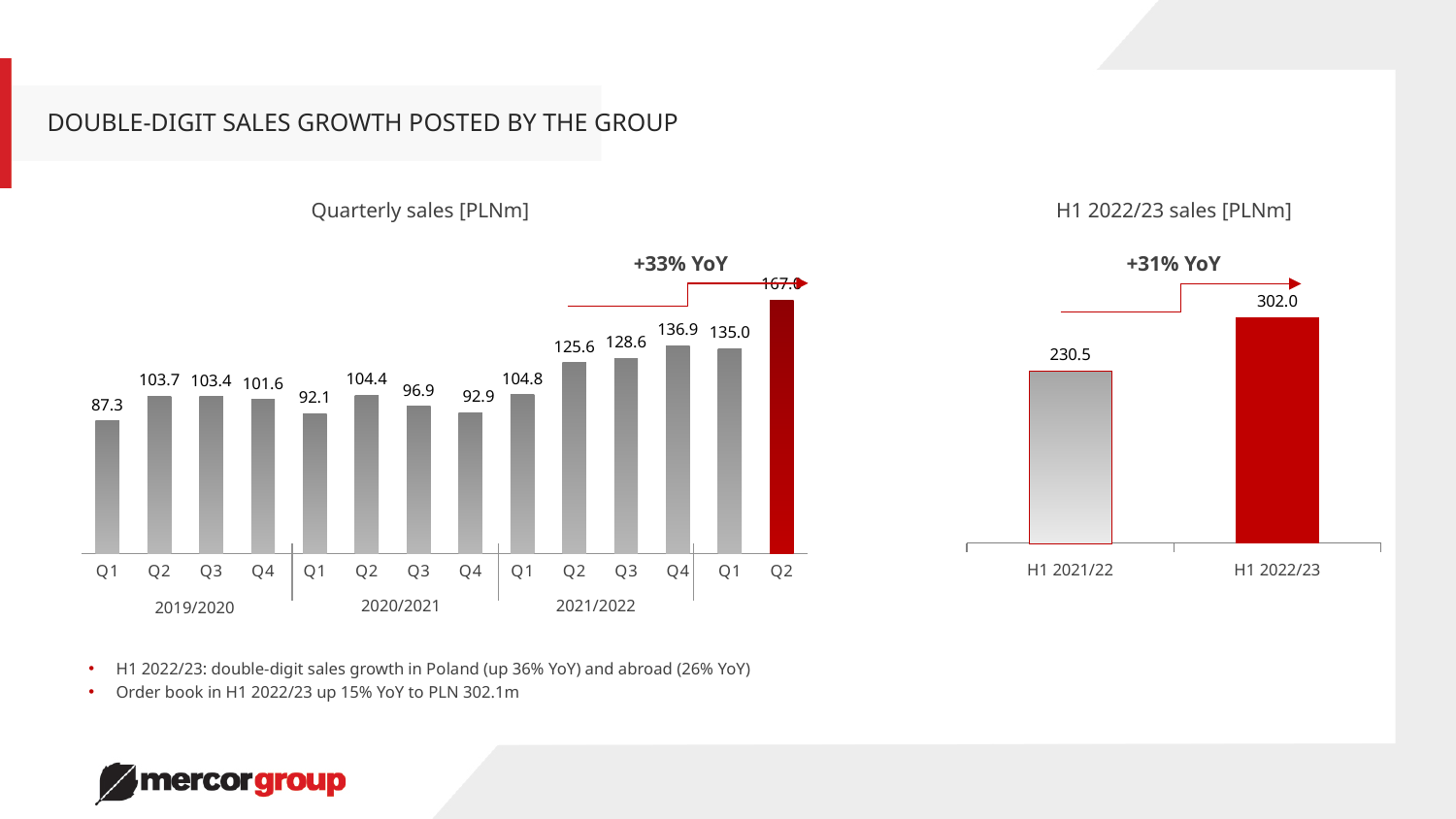
What kind of chart is the Quarterly sales [PLNm] chart? Bar chart In the Quarterly sales [PLNm] chart, what is the value for Q3 2020/2021? 96.9 In the H1 2022/23 sales [PLNm] chart, what is the difference between H1 2022/23 and H1 2021/22? 71.5 How many bars are plotted in the Quarterly sales [PLNm] chart? 14 In the H1 2022/23 sales [PLNm] chart, what is the value for H1 2021/22? 230.5 What YoY growth is annotated on the H1 2022/23 sales [PLNm] chart? +31% YoY In the Quarterly sales [PLNm] chart, which is larger: Q2 2020/2021 or Q2 2021/2022? Q2 2021/2022 In the Quarterly sales [PLNm] chart, what is the difference between Q4 2021/2022 and Q1 2021/2022? 32.1 In the H1 2022/23 sales [PLNm] chart, what is the value for H1 2022/23? 302.0 In the Quarterly sales [PLNm] chart, which quarter has the lowest value? Q1 2019/2020 In the Quarterly sales [PLNm] chart, what is the value for Q1 2019/2020? 87.3 In the Quarterly sales [PLNm] chart, what is the value for Q4 2021/2022? 136.9